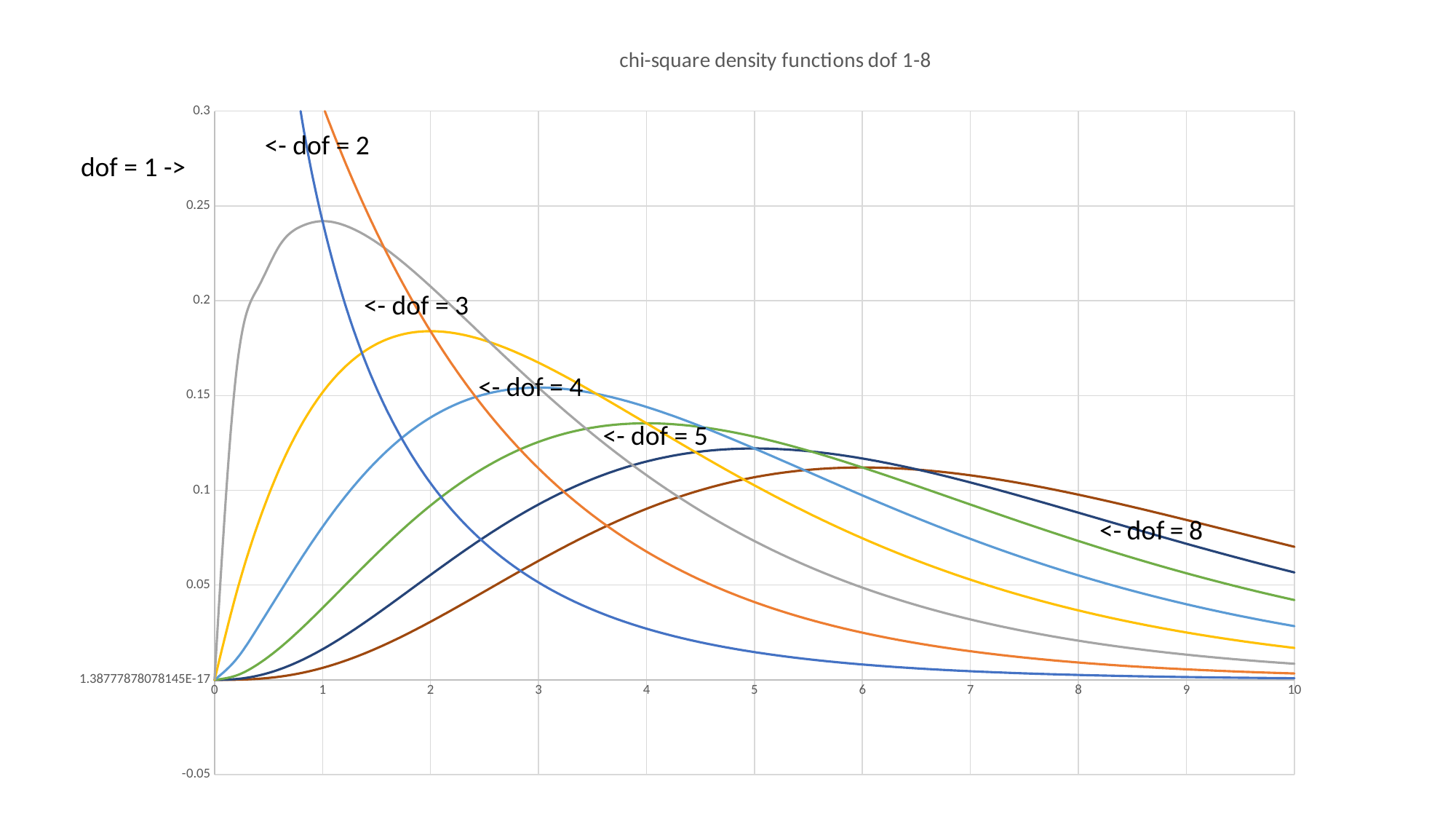
How many density curves are plotted on the chart? 8 Does the dof = 2 curve rise or fall as x increases from 1 to 10? fall What is the highest value shown on the y axis? 0.3 At x = 10, which curve has the larger value, dof = 8 or dof = 2? dof = 8 Is the value of the dof = 8 curve at x = 10 greater or less than 0.05? greater Which labelled curve reaches its peak furthest to the right along the x axis? dof = 8 What is the title of the chart? chi-square density functions dof 1-8 Is the peak value of the dof = 1 curve greater or less than 0.2? greater What kind of chart is shown on the slide? line chart Is the peak value of the dof = 3 curve greater or less than 0.15? greater At x = 1, which curve has the larger value, dof = 1 or dof = 8? dof = 1